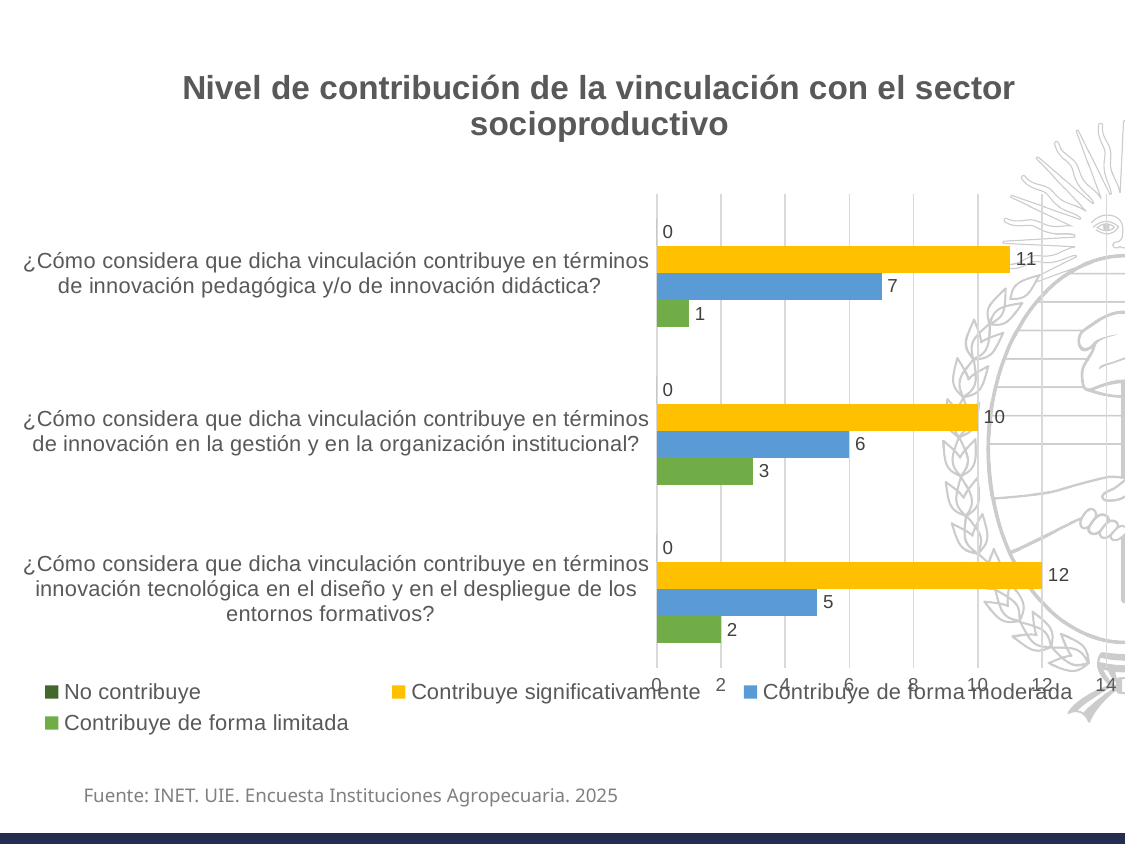
How many series does the legend list? 4 What type of chart is shown on the slide? bar chart What is the difference between the 'Contribuye significativamente' and 'Contribuye de forma moderada' values for the question about innovación tecnológica en el diseño y en el despliegue de los entornos formativos? 7 What is the value of 'Contribuye de forma moderada' for the question about innovación en la gestión y en la organización institucional? 6 What colour represents the 'Contribuye significativamente' series? yellow For which question is the 'Contribuye significativamente' value highest? ¿Cómo considera que dicha vinculación contribuye en términos innovación tecnológica en el diseño y en el despliegue de los entornos formativos? Which is larger for the question about innovación en la gestión y en la organización institucional: 'Contribuye de forma moderada' or 'Contribuye de forma limitada'? Contribuye de forma moderada What is the value of 'No contribuye' for the question about innovación pedagógica y/o de innovación didáctica? 0 For which question is the 'Contribuye de forma limitada' value lowest? ¿Cómo considera que dicha vinculación contribuye en términos de innovación pedagógica y/o de innovación didáctica? What is the value of 'Contribuye significativamente' for the question about innovación pedagógica y/o de innovación didáctica? 11 How many categories (questions) are plotted on the chart? 3 What is the value of 'Contribuye de forma limitada' for the question about innovación tecnológica en el diseño y en el despliegue de los entornos formativos? 2